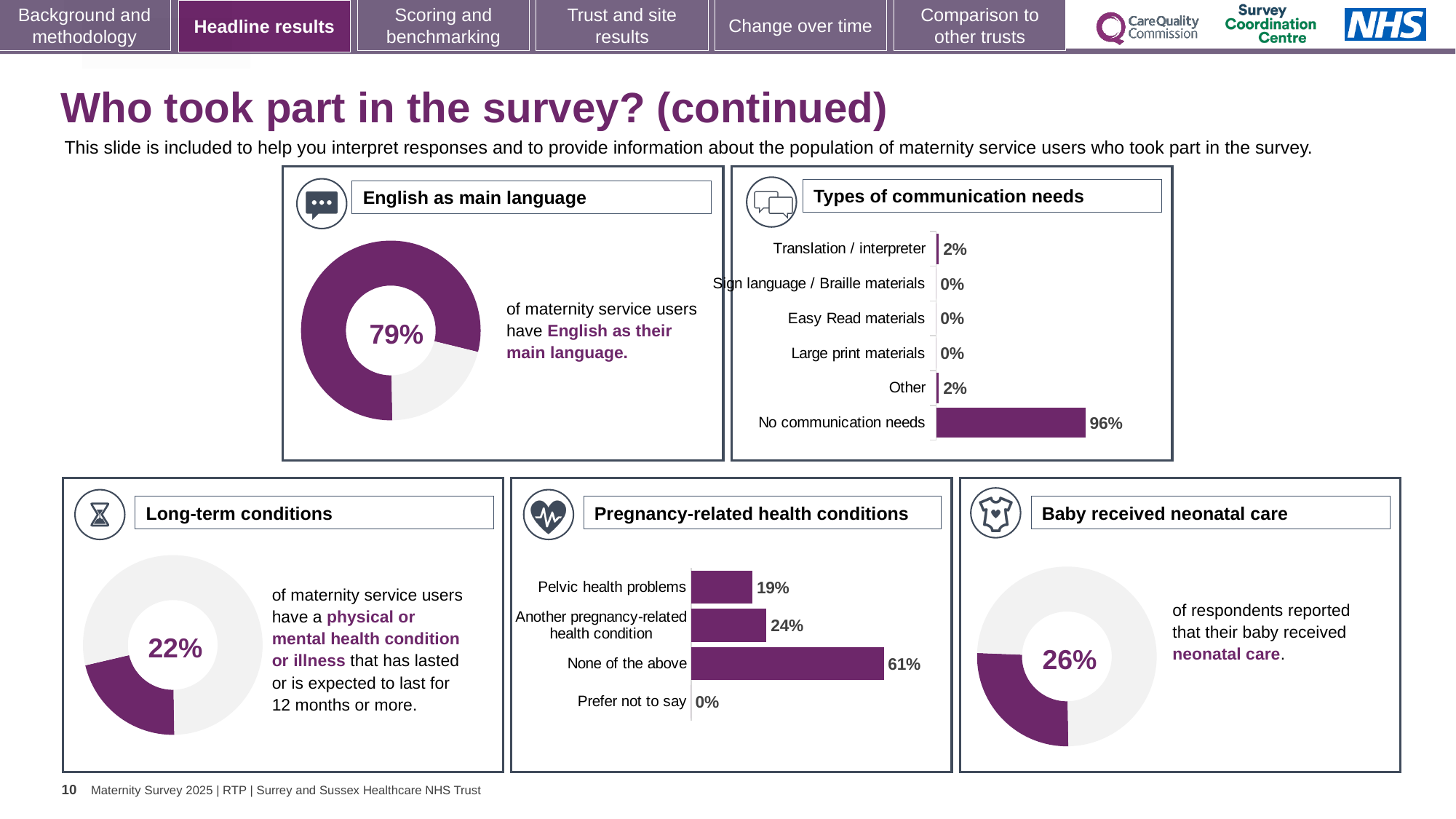
In the 'Pregnancy-related health conditions' chart, which category has the highest value? None of the above In the 'Types of communication needs' chart, what is the value for 'Translation / interpreter'? 2% In the 'Types of communication needs' chart, how many categories are shown? 6 What kind of chart is used in the 'Baby received neonatal care' panel? Donut chart In the 'Types of communication needs' chart, what is the value for 'No communication needs'? 96% What percentage is shown in the 'Long-term conditions' donut chart? 22% In the 'Types of communication needs' chart, which category has the highest value? No communication needs In the 'Pregnancy-related health conditions' chart, what is the value for 'Pelvic health problems'? 19% In the 'Pregnancy-related health conditions' chart, what is the value for 'Another pregnancy-related health condition'? 24% In the 'Pregnancy-related health conditions' chart, what is the difference between 'None of the above' and 'Pelvic health problems'? 42% What percentage is shown in the 'English as main language' donut chart? 79% In the 'Pregnancy-related health conditions' chart, which is larger: 'Pelvic health problems' or 'Another pregnancy-related health condition'? Another pregnancy-related health condition